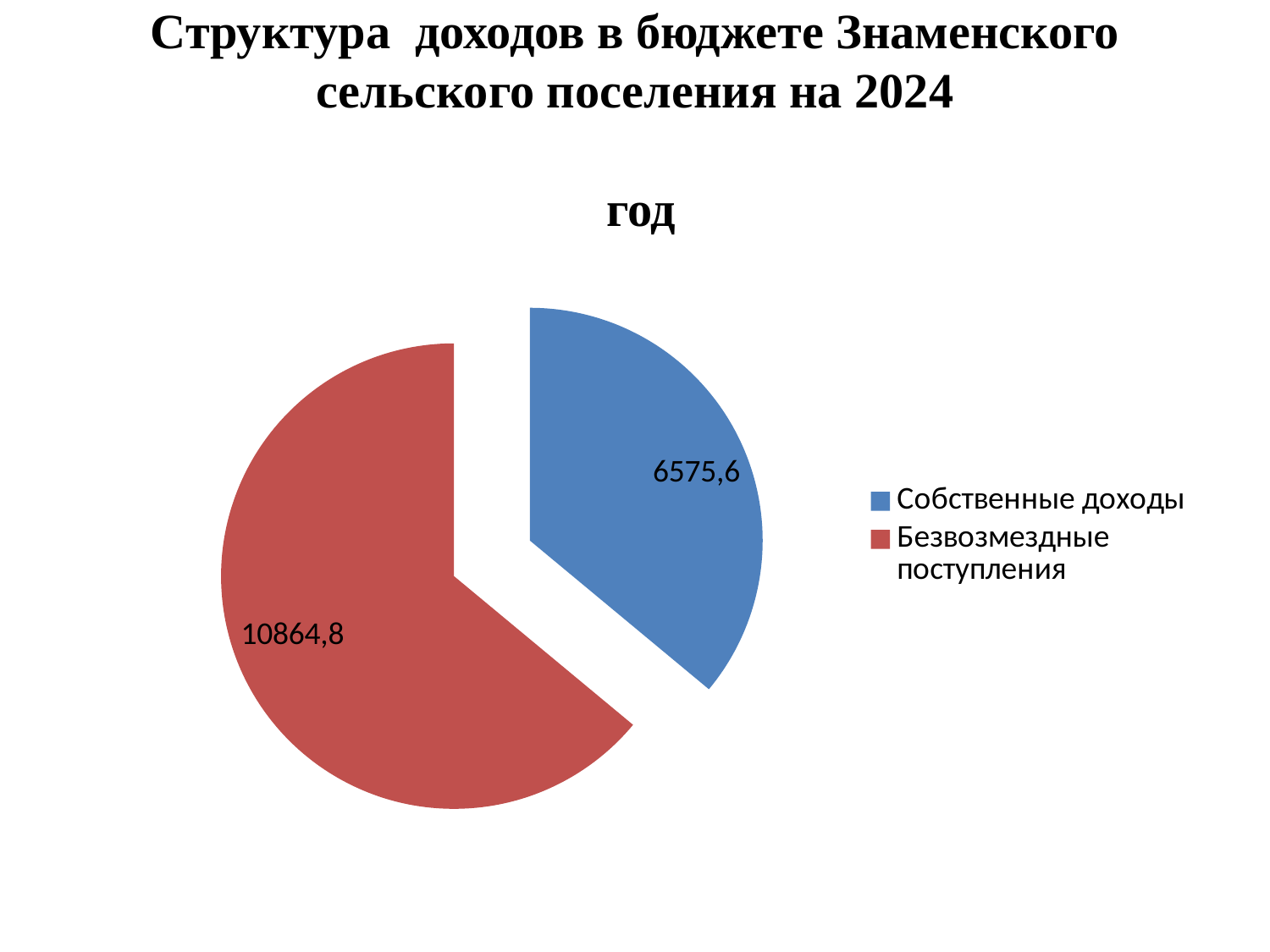
Which category has the largest slice of the pie? Безвозмездные поступления What is the difference between Безвозмездные поступления and Собственные доходы? 4289,2 What is the total of the two slices in the pie chart? 17440,4 What share of the total does Собственные доходы represent, to one decimal place? 37.7% How many slices does the pie chart have? 2 What kind of chart is shown on the slide? Pie chart Which is larger, Собственные доходы or Безвозмездные поступления? Безвозмездные поступления What is the value for Собственные доходы? 6575,6 What is the value for Безвозмездные поступления? 10864,8 Which category has the smallest slice of the pie? Собственные доходы How many entries does the legend list? 2 What colour is the slice for Безвозмездные поступления? Red